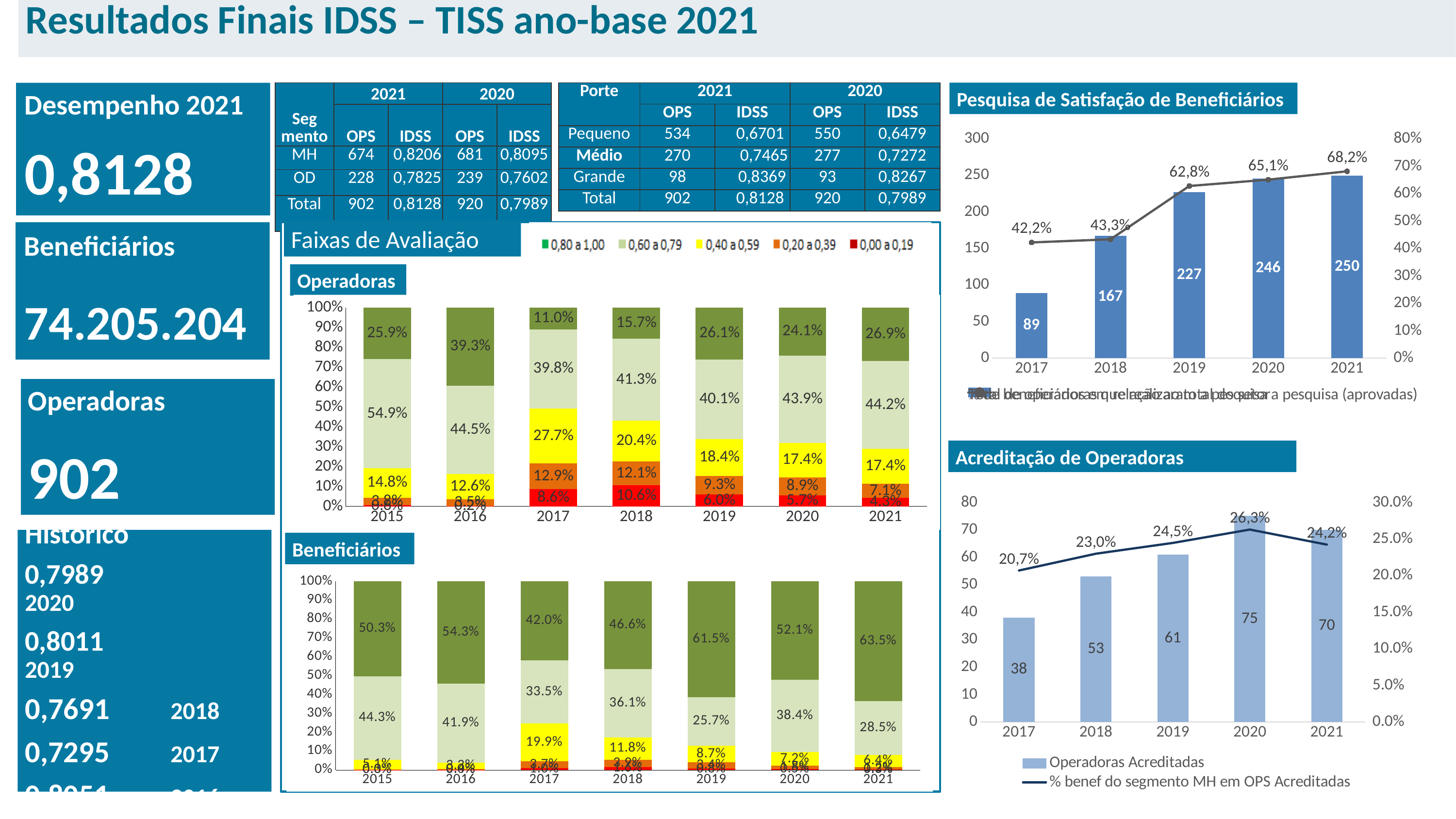
In the 'Acreditação de Operadoras' chart, which year has the highest percentage on the line series? 2020 In the 'Pesquisa de Satisfação de Beneficiários' chart, what is the bar value for 2021? 250 In the 'Beneficiários' stacked bar chart under 'Faixas de Avaliação', what is the share of the top (0,80 a 1,00) band in 2021? 63.5% In the 'Acreditação de Operadoras' chart, is the bar value for 2021 larger or smaller than the bar value for 2020? smaller In the 'Pesquisa de Satisfação de Beneficiários' chart, what percentage does the line show for 2019? 62,8% In the 'Acreditação de Operadoras' chart, how many Operadoras Acreditadas are shown for 2020? 75 In the 'Pesquisa de Satisfação de Beneficiários' chart, which year has the lowest bar value? 2017 How many bands does the legend of the 'Faixas de Avaliação' charts list? 5 In the 'Acreditação de Operadoras' chart, how many series does the legend list? 2 In the 'Operadoras' stacked bar chart under 'Faixas de Avaliação', how many years are shown on the x axis? 7 In the 'Pesquisa de Satisfação de Beneficiários' chart, what is the difference between the bar values for 2018 and 2017? 78 In the 'Operadoras' stacked bar chart under 'Faixas de Avaliação', what is the share of the 0,80 a 1,00 band in 2021? 26.9%